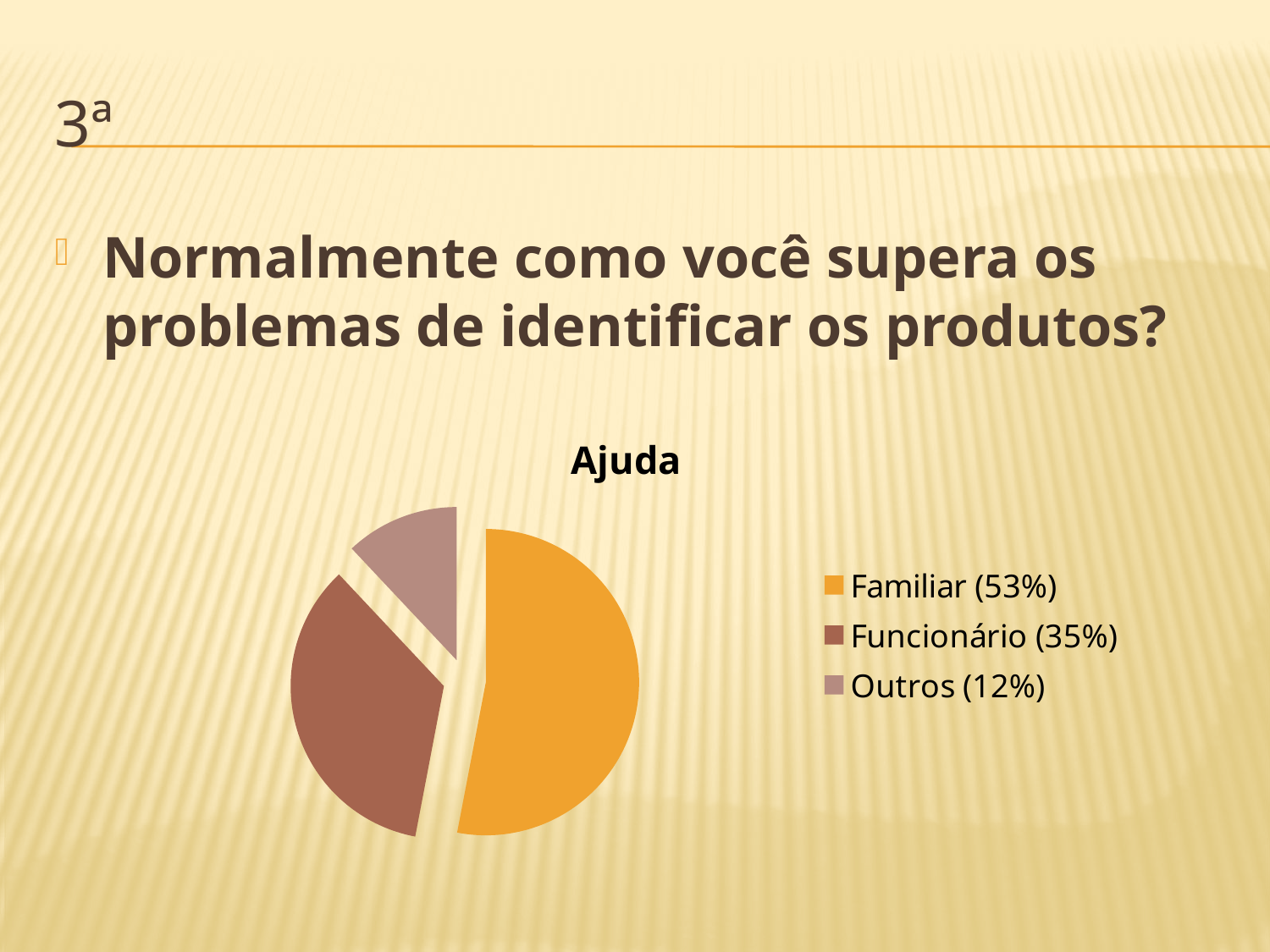
What share of the pie does Outros represent? 12% What share of the pie does Funcionário represent? 35% How many slices does the pie chart have? 3 What is the difference in percentage points between Funcionário and Outros? 23 What is the title of the chart? Ajuda Which category has the largest slice of the pie? Familiar What share of the pie does Familiar represent? 53% What kind of chart is shown on the slide? pie chart Which is larger, the share for Funcionário or the share for Outros? Funcionário What is the difference in percentage points between Familiar and Funcionário? 18 Which category has the smallest slice of the pie? Outros Which category is shown in orange in the legend? Familiar (53%)